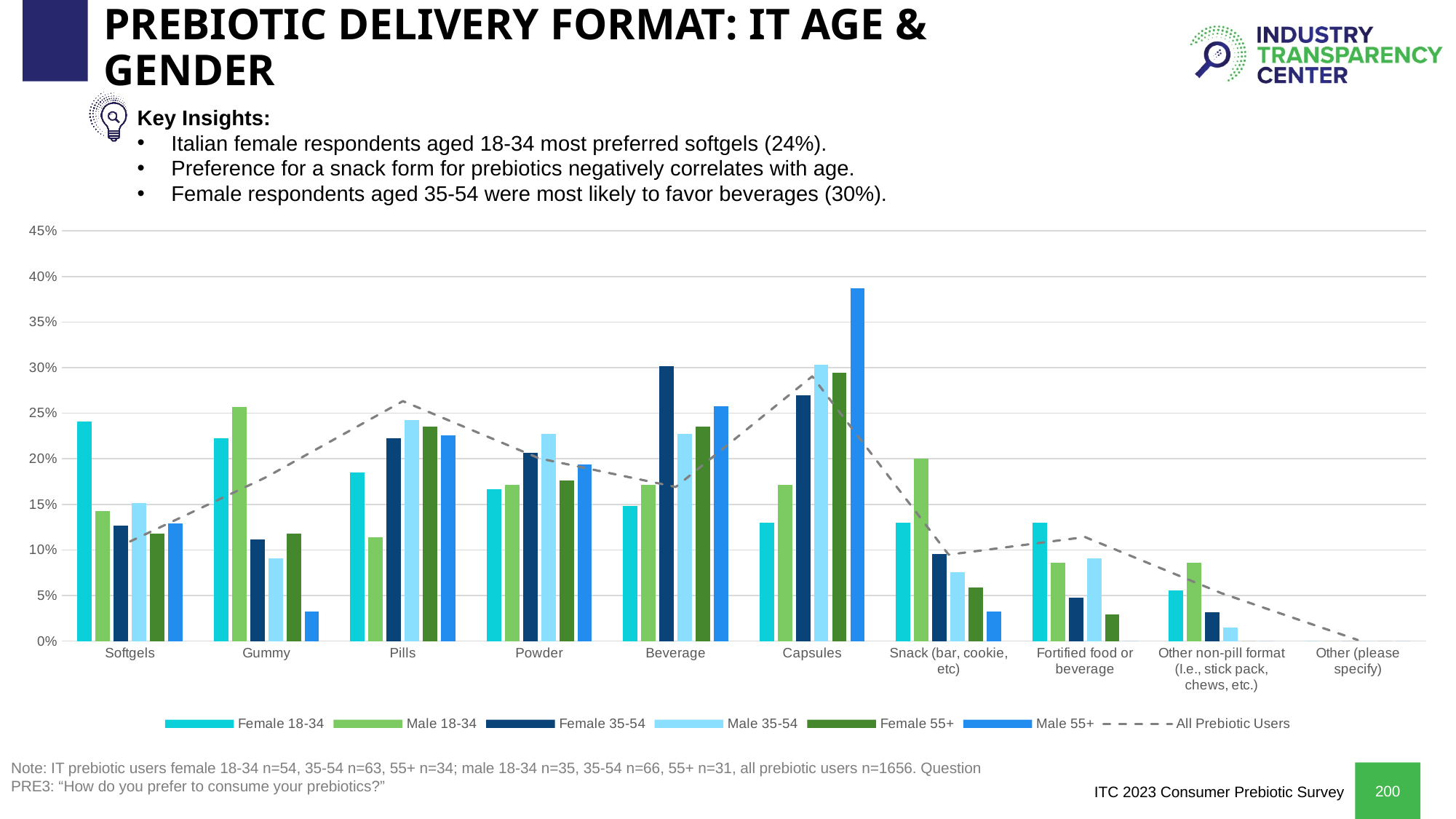
Is the value for Male 55+ in the Capsules category greater or less than 35%? greater Within the Snack (bar, cookie, etc) category, which series has the highest value? Male 18-34 What kind of chart is shown on the slide? combination bar and line chart Within the Capsules category, which series has the highest value? Male 55+ What does the dashed line in the chart represent? All Prebiotic Users Which category has the tallest bar in the chart? Capsules Is the value for Female 35-54 in the Beverage category greater or less than 25%? greater Is the value for Male 55+ in the Gummy category greater or less than 5%? less How many series does the legend list? 7 In the Pills category, which is larger: Female 35-54 or Male 18-34? Female 35-54 Within the Gummy category, which series has the lowest value? Male 55+ How many delivery format categories are shown on the x axis? 10